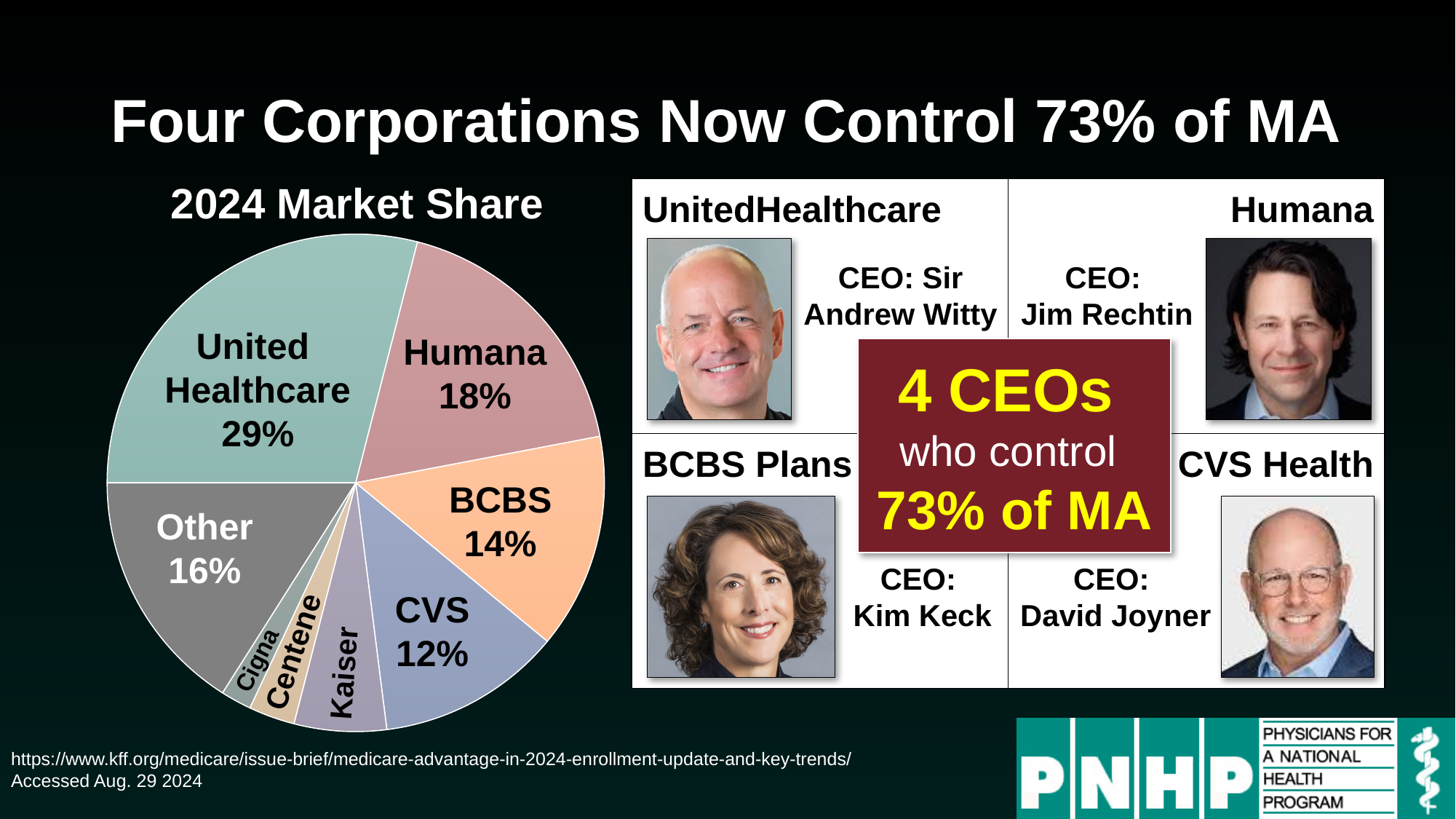
What type of chart is shown on the slide? pie chart What is the market share for Humana? 18% What is the difference in market share between United Healthcare and Humana? 11 percentage points What is the market share for BCBS? 14% What is the market share for CVS? 12% How many slices does the pie chart have? 8 Which slice is larger, Kaiser or Centene? Kaiser Which slice has the largest market share? United Healthcare What is the market share for the Other slice? 16% Which has a larger market share, Humana or BCBS? Humana What is the title of the chart? 2024 Market Share What is the market share for United Healthcare? 29%